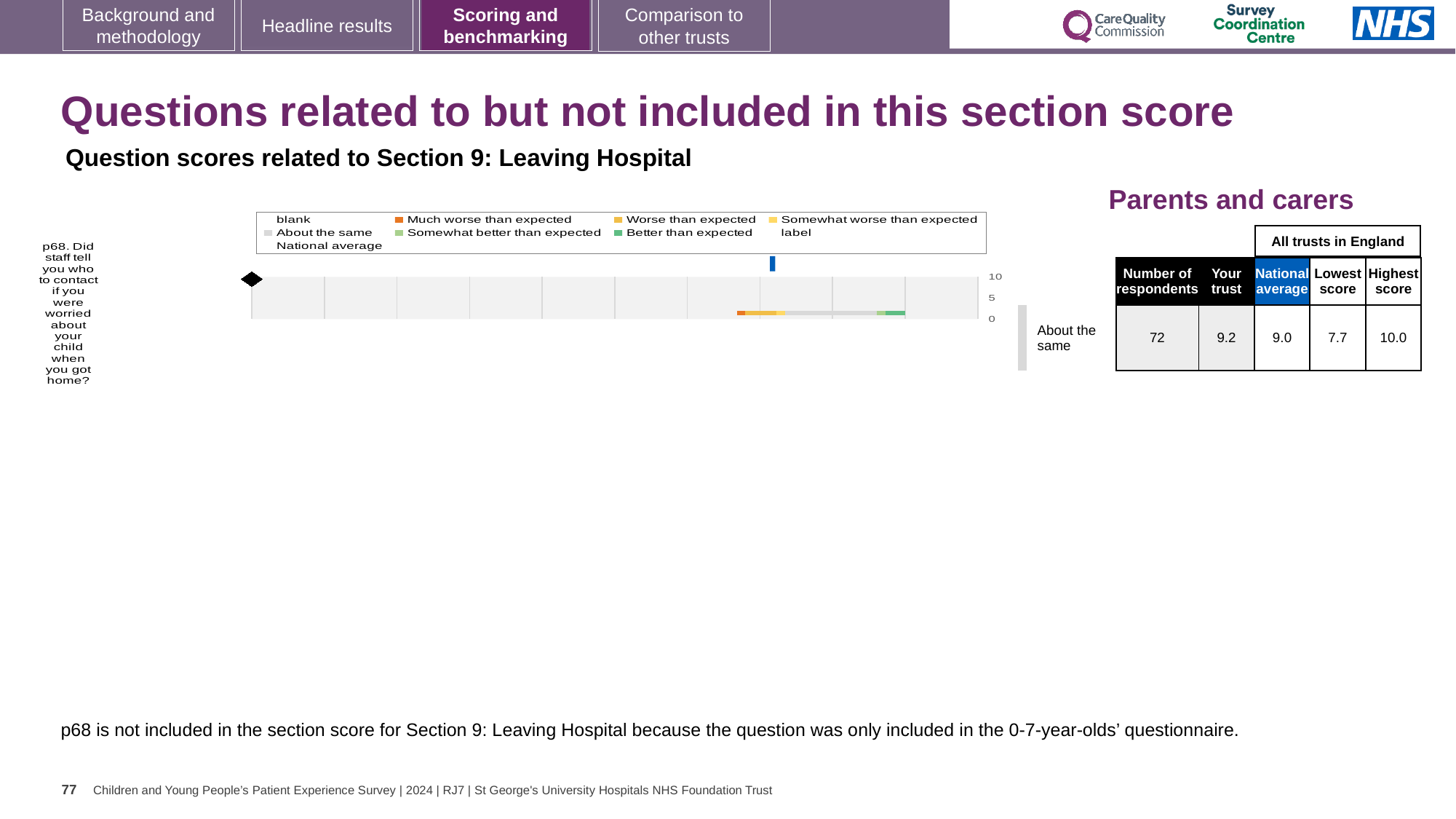
What is the 'Your trust' score for p68? 9.2 What benchmark category is the trust's p68 score placed in? About the same How many survey questions are plotted in the chart? 1 What is the highest score across all trusts in England for p68? 10.0 How many respondents answered p68? 72 What kind of chart is used to show the p68 question score? bar chart What is the lowest score across all trusts in England for p68? 7.7 Which legend entry is shown in dark green? Better than expected Which is larger for p68, the 'Your trust' score or the national average? Your trust Which legend entry is shown in orange? Much worse than expected What is the national average score for p68? 9.0 What is the difference between the highest and lowest scores for p68? 2.3